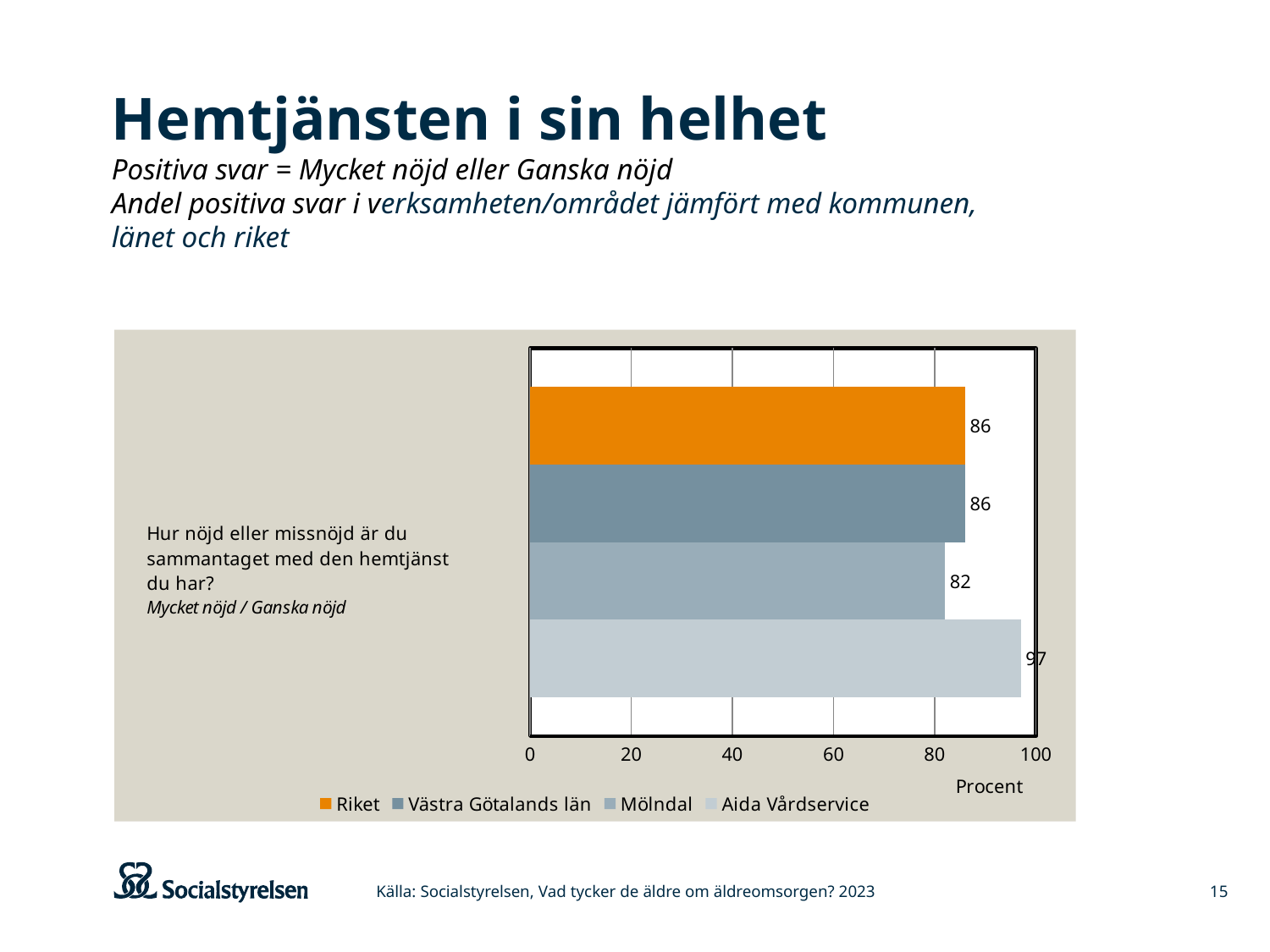
Which series has the lowest value? Mölndal What value is shown for Riket? 86 What is the difference between the values for Riket and Mölndal? 4 What is the label on the horizontal axis of the chart? Procent Which is larger, the value for Aida Vårdservice or the value for Riket? Aida Vårdservice What value is shown for Mölndal? 82 What kind of chart is shown on the slide? Bar chart What value is shown for Aida Vårdservice? 97 What is the difference between the values for Aida Vårdservice and Mölndal? 15 How many series does the legend list? 4 Which series has the highest value? Aida Vårdservice What value is shown for Västra Götalands län? 86